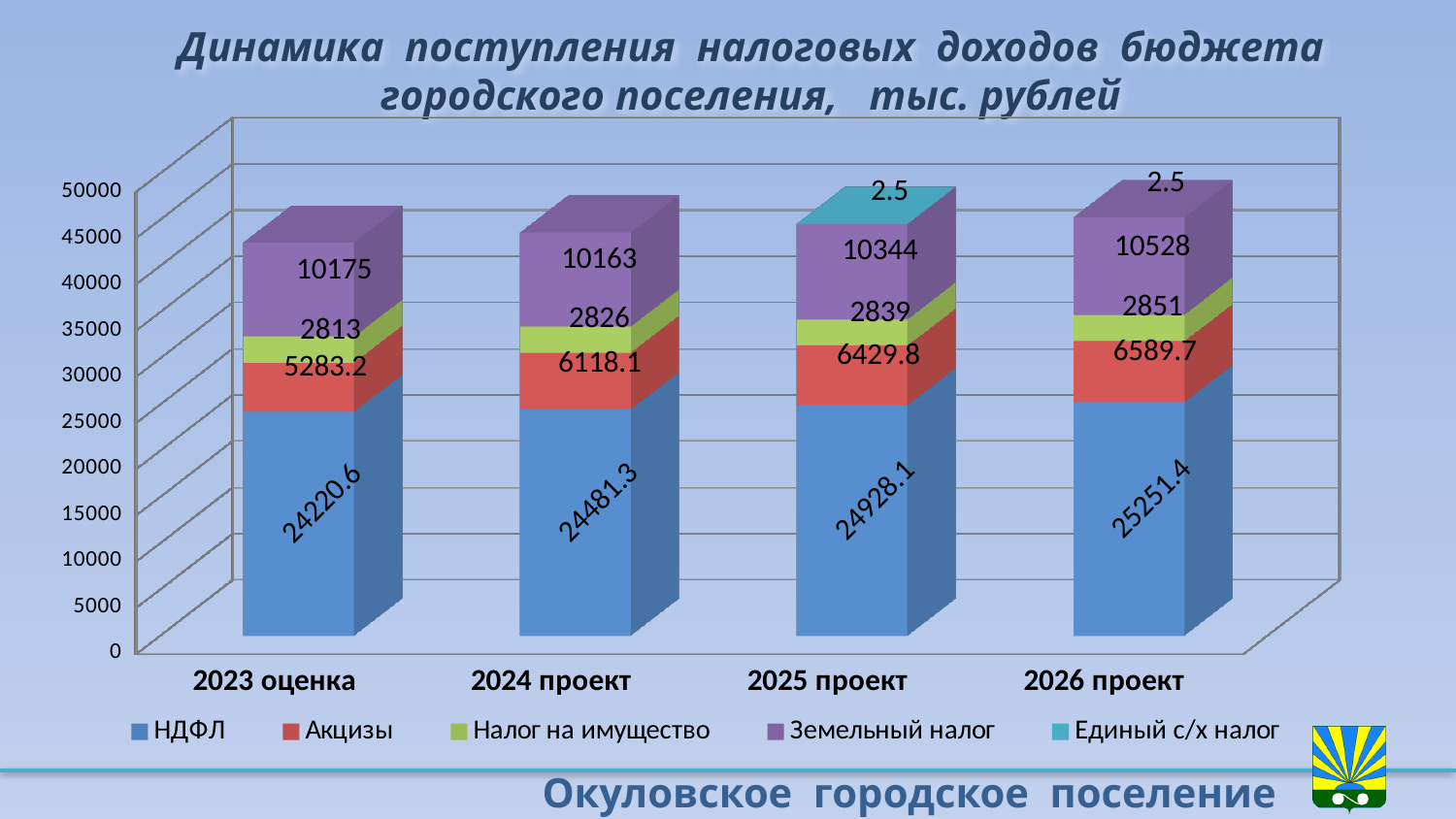
What is the value of Акцизы for 2025 проект? 6429.8 What is the value of Единый с/х налог for 2025 проект? 2.5 Which is larger: Земельный налог in 2023 оценка or in 2024 проект? 2023 оценка What is the value of Земельный налог for 2026 проект? 10528 In which year is Земельный налог the highest? 2026 проект In which year is Акцизы the lowest? 2023 оценка What is the value of НДФЛ for 2023 оценка? 24220.6 What is the difference between Акцизы in 2026 проект and 2023 оценка? 1306.5 What kind of chart is shown on the slide? Stacked bar chart How many series does the legend list? 5 Does НДФЛ rise or fall from 2023 оценка to 2026 проект? Rises How many years (categories) are shown on the x axis? 4